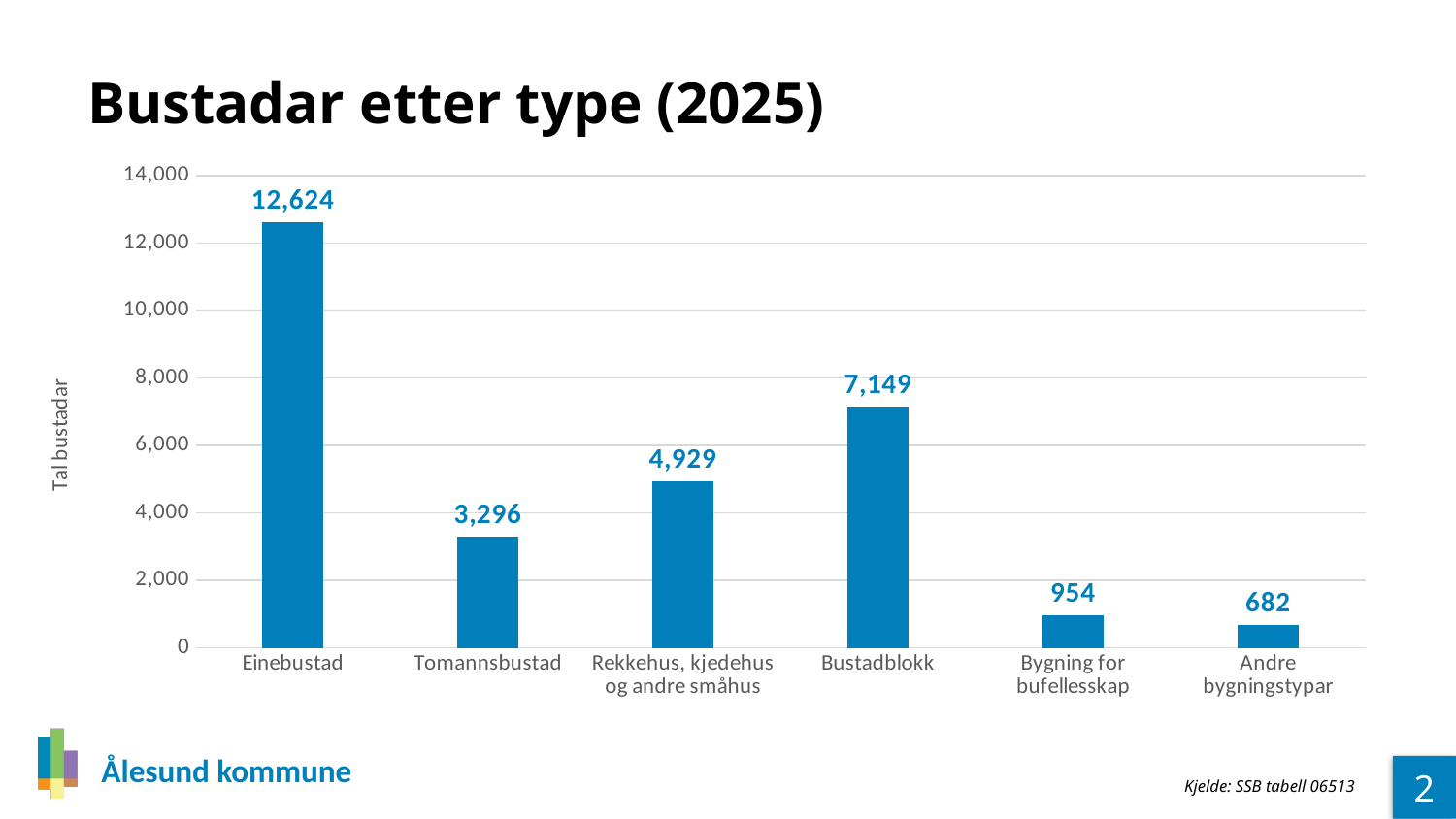
Which category has the lowest value? Andre bygningstypar What kind of chart is shown on the slide? bar chart What is the value for Bustadblokk? 7,149 What is the value for Bygning for bufellesskap? 954 What is the difference between the values for Einebustad and Bustadblokk? 5,475 Which is larger, the value for Tomannsbustad or the value for Rekkehus, kjedehus og andre småhus? Rekkehus, kjedehus og andre småhus What is the difference between the values for Rekkehus, kjedehus og andre småhus and Tomannsbustad? 1,633 Is the value for Bustadblokk greater or less than 8,000? less Which category has the highest value? Einebustad What is the value for Einebustad? 12,624 How many categories are shown on the x axis? 6 What is the title of the chart? Bustadar etter type (2025)